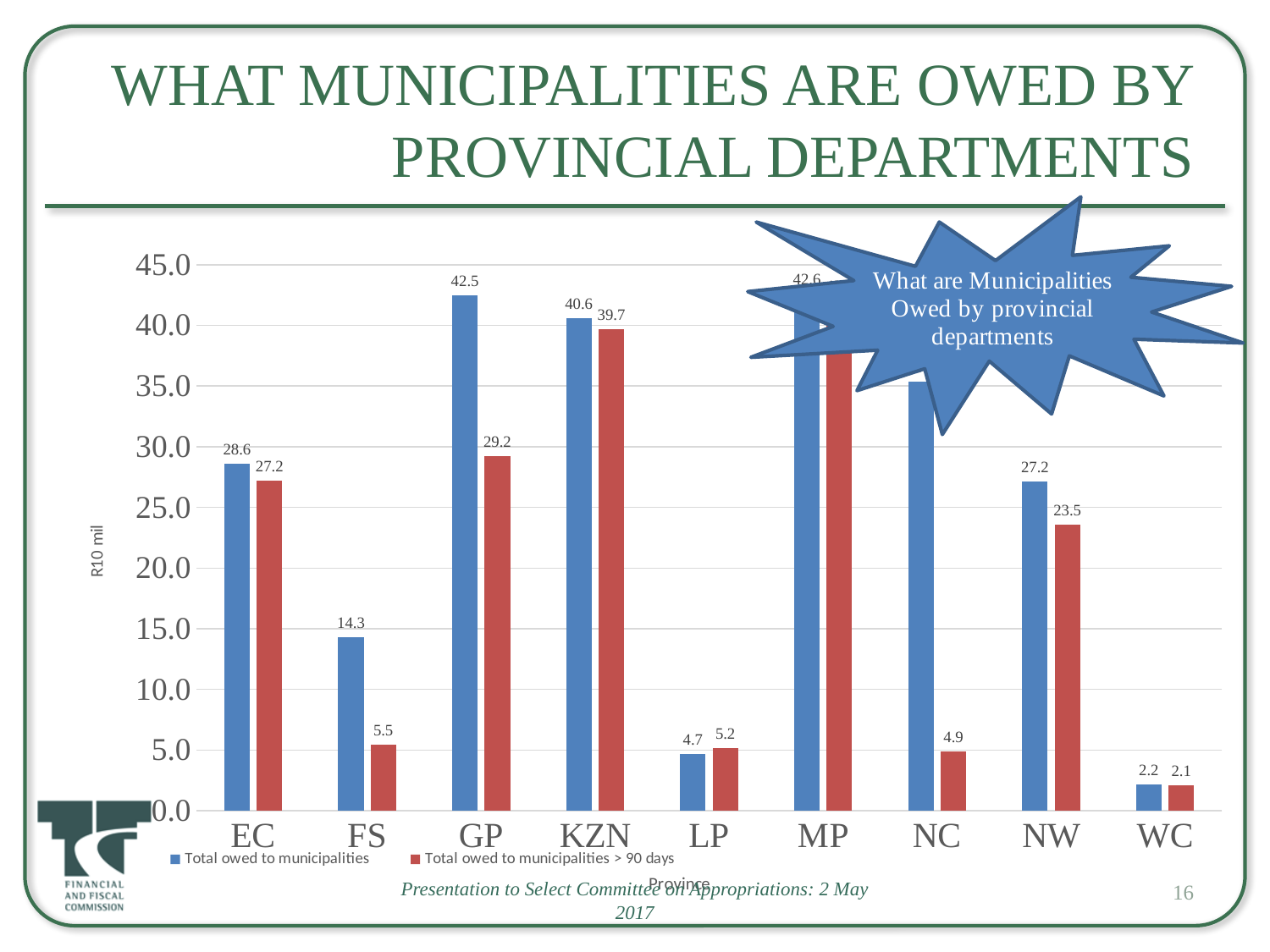
What kind of chart is shown on the slide? bar chart What is the difference between 'Total owed to municipalities' and 'Total owed to municipalities > 90 days' for EC? 1.4 What is the value of 'Total owed to municipalities' for GP? 42.5 What is the difference between 'Total owed to municipalities' and 'Total owed to municipalities > 90 days' for FS? 8.8 What is the value of 'Total owed to municipalities > 90 days' for NW? 23.5 What is the label on the y axis? R10 mil Which province has the lowest value for 'Total owed to municipalities'? WC How many provinces are shown on the x axis? 9 What is the value of 'Total owed to municipalities > 90 days' for KZN? 39.7 For LP, which series has the larger value: 'Total owed to municipalities' or 'Total owed to municipalities > 90 days'? Total owed to municipalities > 90 days How many series does the legend list? 2 Is the value of 'Total owed to municipalities' for NC greater or less than 30.0? greater